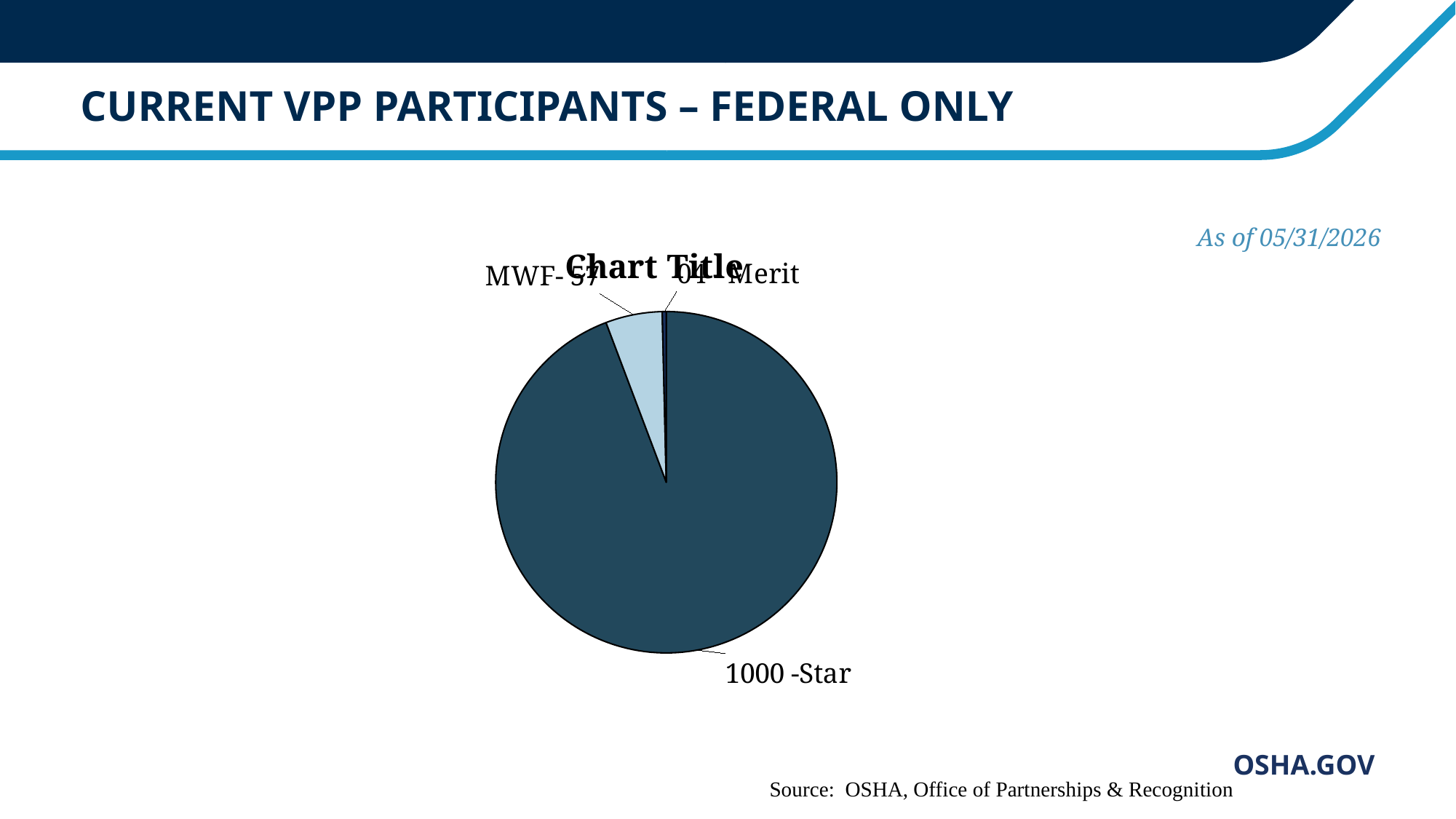
What colour is the Star slice of the pie chart? dark teal Which category has the largest slice of the pie chart? Star Which slice is larger in the pie chart, MWF or Merit? MWF What is the title printed above the pie chart? Chart Title What is the value shown for the Star slice of the pie chart? 1000 Which slice is larger in the pie chart, Star or MWF? Star Which category has the smallest slice of the pie chart? Merit What kind of chart is shown on the slide? pie chart How many slices does the pie chart have? 3